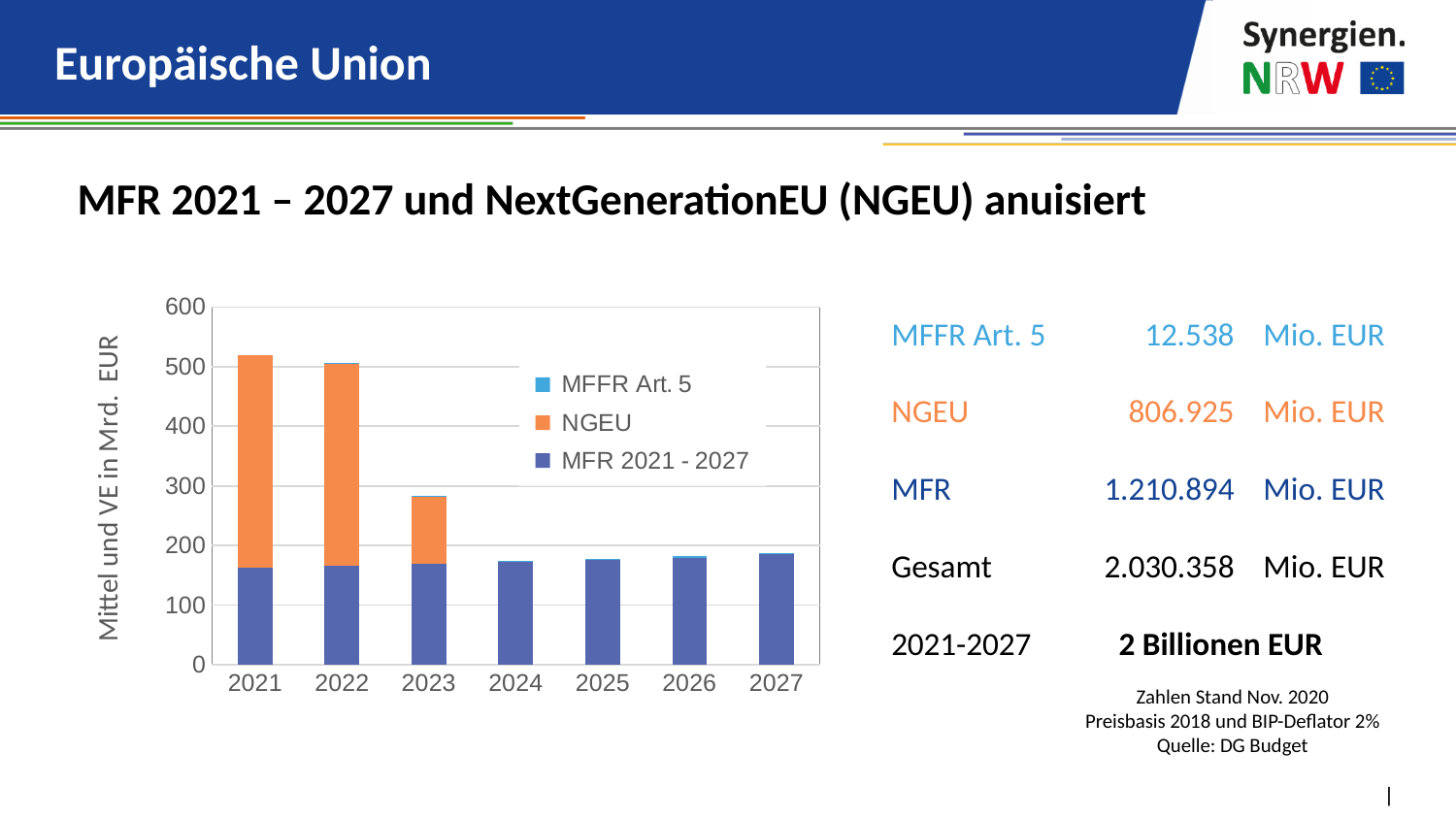
Is the total bar for 2021 greater or less than 500? greater What kind of chart is shown on the slide? stacked bar chart Which year has the larger total bar, 2021 or 2023? 2021 What are the three series listed in the chart legend? MFFR Art. 5, NGEU, MFR 2021 - 2027 Is the total bar for 2024 greater or less than 200? less Do the total bars rise or fall from 2021 to 2024? fall What is the label of the chart's y axis? Mittel und VE in Mrd. EUR Which year has the highest total bar in the chart? 2021 How many series does the chart legend list? 3 How many years are shown on the x axis of the chart? 7 Is the total bar for 2027 greater or less than 200? less